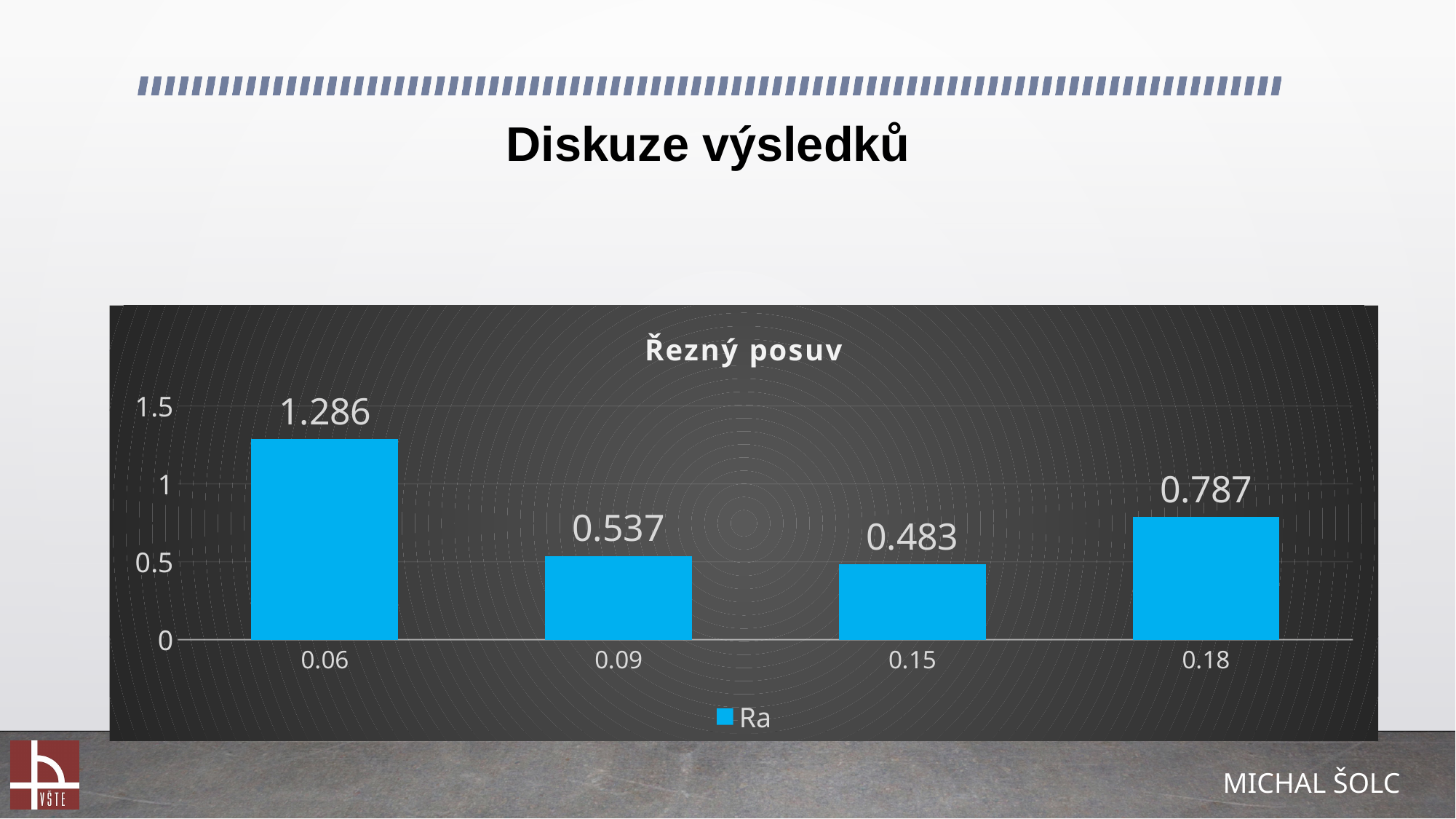
Which category has the lowest Ra value? 0.15 What is the Ra value for the category 0.18? 0.787 Which has a larger Ra value, 0.09 or 0.18? 0.18 Which category has the highest Ra value? 0.06 What is the difference between the Ra values for 0.06 and 0.09? 0.749 What type of chart is shown on the slide? bar chart What is the Ra value for the category 0.06? 1.286 How many categories are shown on the x axis? 4 What is the difference between the Ra values for 0.18 and 0.15? 0.304 Is the Ra value for 0.06 greater or less than 1? greater What is the title of the chart? Řezný posuv What is the Ra value for the category 0.15? 0.483